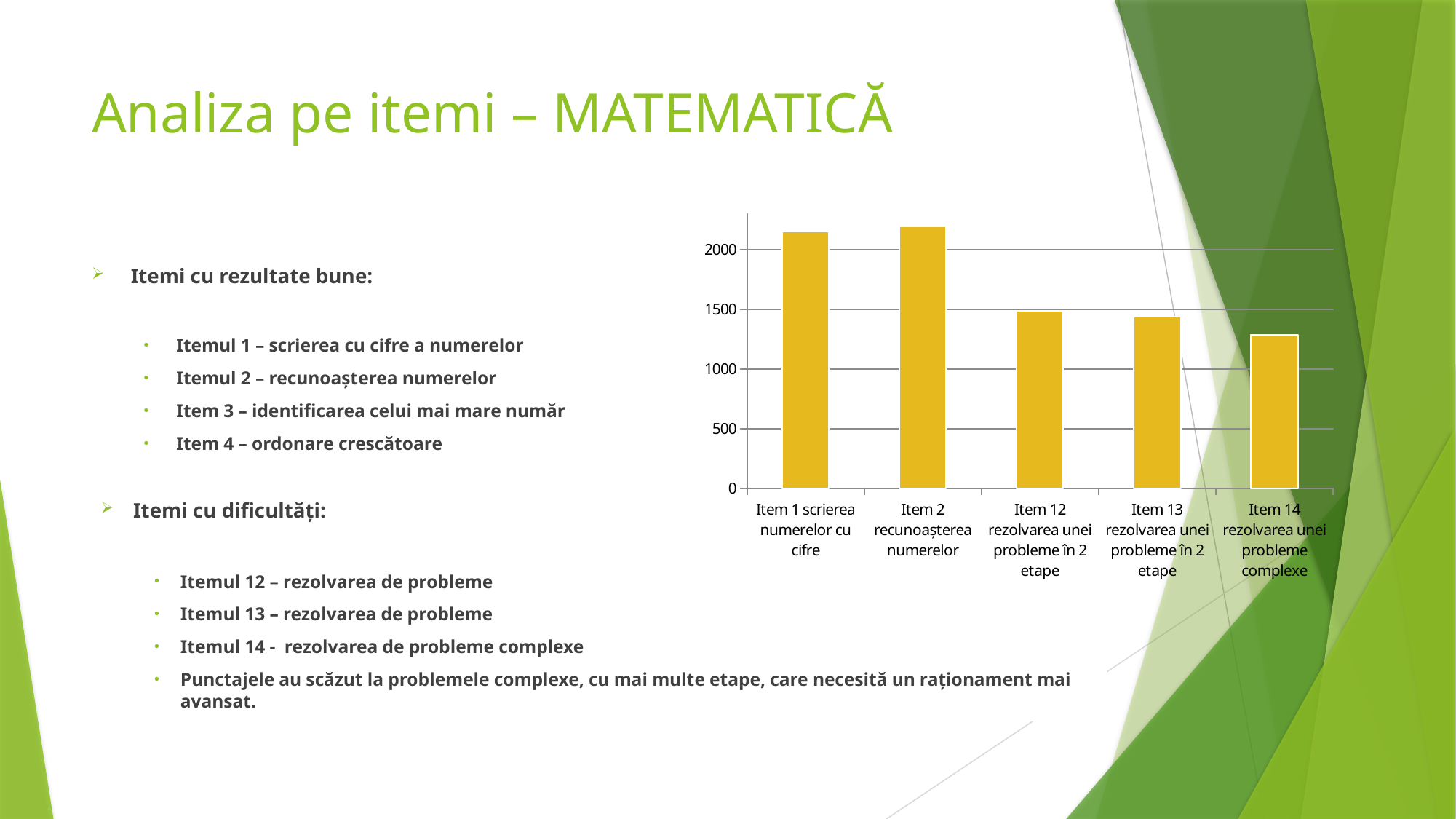
Which item has the lowest value in the chart? Item 14 rezolvarea unei probleme complexe Do the values in the chart generally rise or fall from left to right along the x axis? fall Is the value for Item 14 rezolvarea unei probleme complexe greater or less than 1000? greater Is the value for Item 2 recunoașterea numerelor greater or less than 2000? greater Which has the larger value: Item 13 rezolvarea unei probleme în 2 etape or Item 14 rezolvarea unei probleme complexe? Item 13 rezolvarea unei probleme în 2 etape What colour are the bars in the chart? yellow Is the value for Item 13 rezolvarea unei probleme în 2 etape greater or less than 1500? less Which has the larger value: Item 1 scrierea numerelor cu cifre or Item 12 rezolvarea unei probleme în 2 etape? Item 1 scrierea numerelor cu cifre How many items (categories) are plotted in the chart? 5 What kind of chart is shown on the slide? bar chart